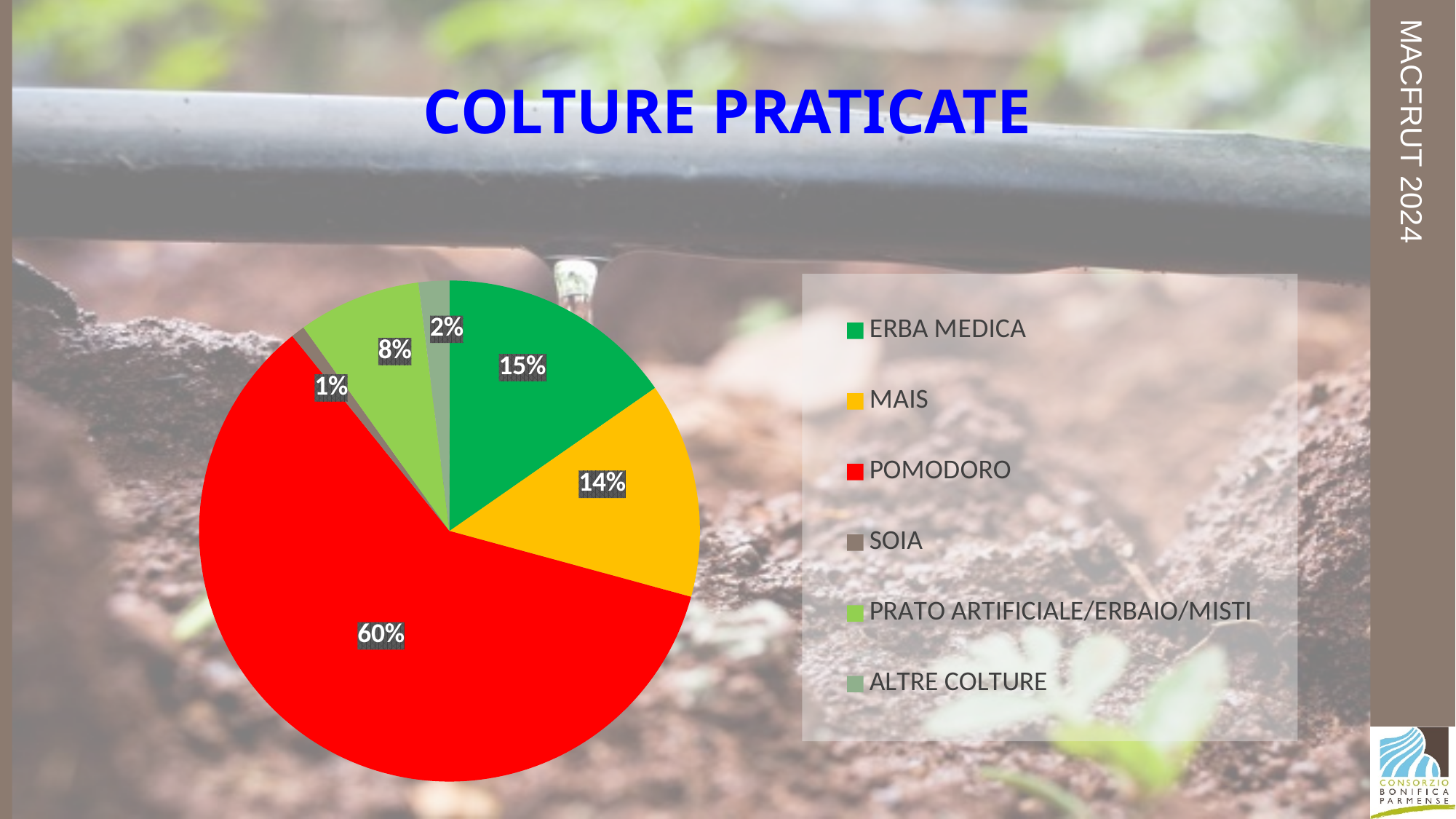
What is the value shown for ERBA MEDICA? 15% What is the value shown for SOIA? 1% What is the value shown for MAIS? 14% What is the value shown for ALTRE COLTURE? 2% What is the difference between the POMODORO and ERBA MEDICA shares? 45% Which category has the largest slice of the pie? POMODORO What is the value shown for PRATO ARTIFICIALE/ERBAIO/MISTI? 8% What kind of chart is shown on the slide? Pie chart How many categories does the pie chart show? 6 Which is larger, the share for ERBA MEDICA or the share for PRATO ARTIFICIALE/ERBAIO/MISTI? ERBA MEDICA What share of the pie does POMODORO represent? 60% Which category has the smallest slice of the pie? SOIA